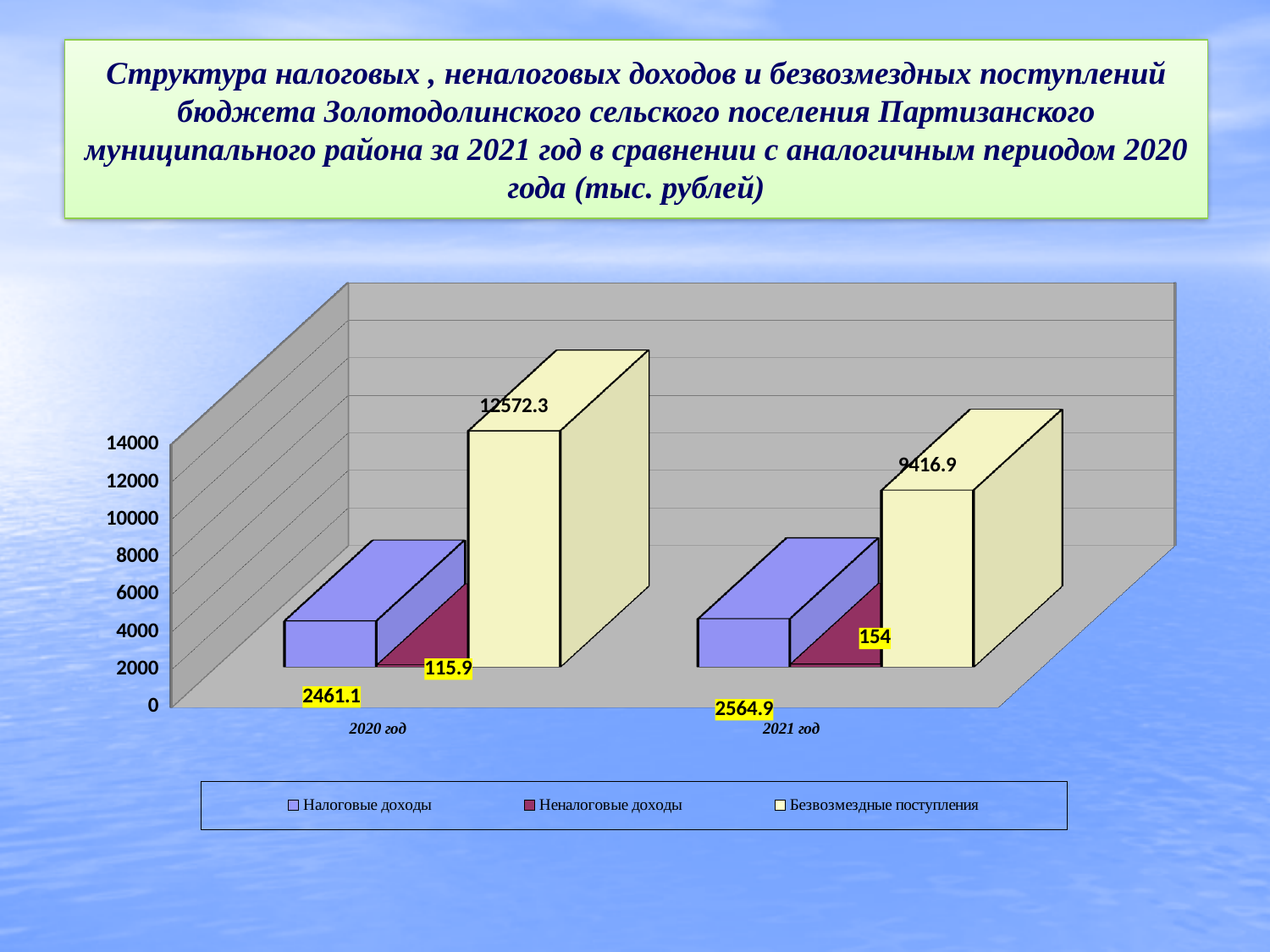
What is the value of Налоговые доходы for 2020 год? 2461.1 How many categories are shown on the x axis? 2 What is the value of Безвозмездные поступления for 2020 год? 12572.3 What is the value of Безвозмездные поступления for 2021 год? 9416.9 What kind of chart is shown on the slide? Bar chart How many series does the legend list? 3 Which series has the lowest value in 2020 год? Неналоговые доходы What is the value of Неналоговые доходы for 2021 год? 154 Which is larger: Налоговые доходы in 2020 год or in 2021 год? 2021 год Is the value of Безвозмездные поступления for 2020 год greater or less than 12000? greater Which series has the highest value in 2021 год? Безвозмездные поступления What is the difference between Безвозмездные поступления in 2020 год and 2021 год? 3155.4